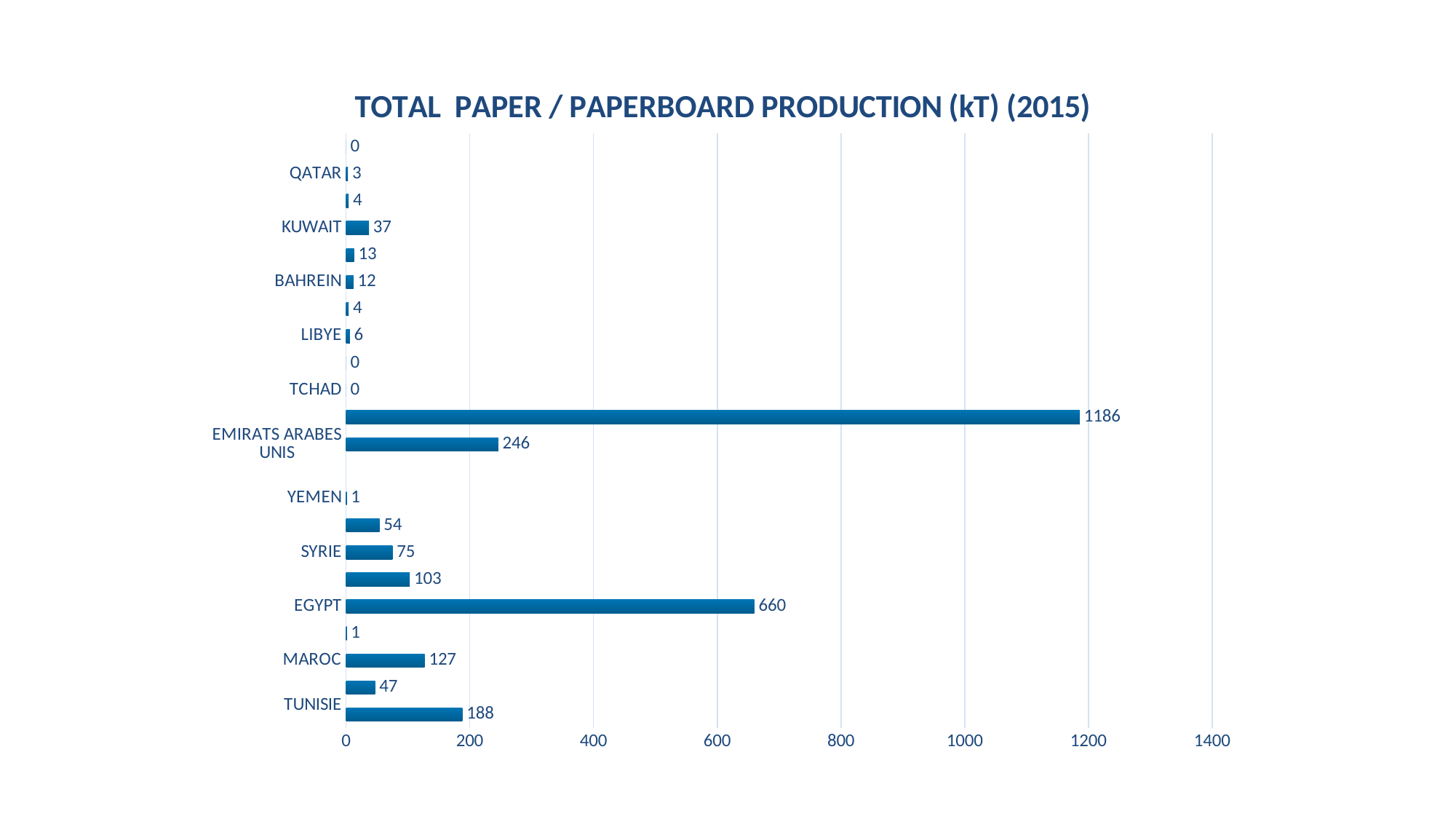
What is the value shown for MAROC? 127 What is the difference between the values for TUNISIE and SYRIE? 113 What is the value shown for TUNISIE? 188 What is the difference between the values for EGYPT and MAROC? 533 Which has the larger value, EGYPT or TUNISIE? EGYPT What is the value shown for KUWAIT? 37 What is the total paper / paperboard production value for EGYPT? 660 What is the value shown for BAHREIN? 12 What kind of chart is shown on the slide? bar chart What is the title of the chart? TOTAL PAPER / PAPERBOARD PRODUCTION (kT) (2015) What is the highest value plotted on the chart? 1186 What is the value shown for TCHAD? 0